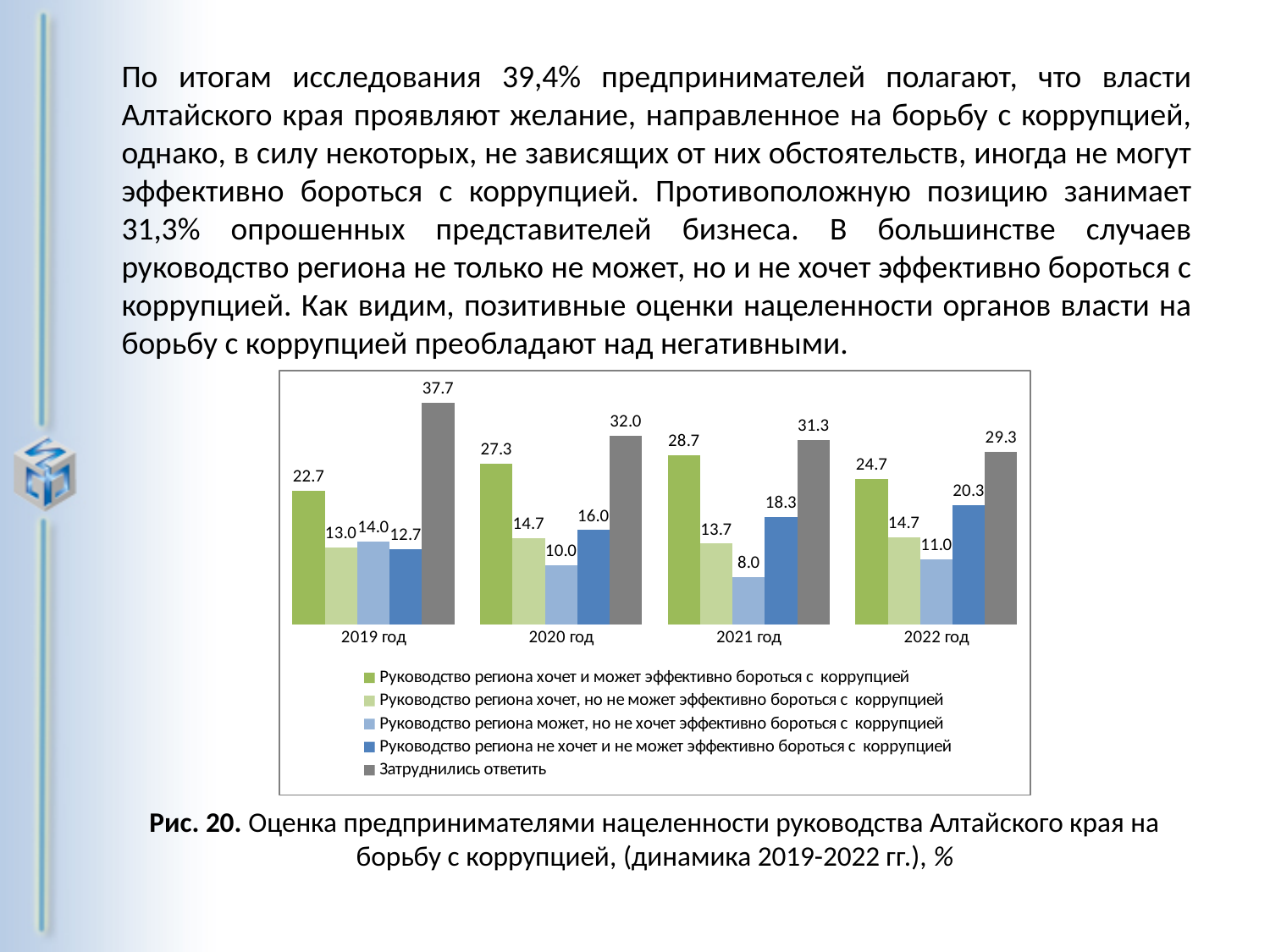
How does the value for 'Руководство региона не хочет и не может эффективно бороться с коррупцией' change from 2019 год to 2022 год? rises In which year is the value for 'Затруднились ответить' the highest? 2019 год What is the value for 'Руководство региона не хочет и не может эффективно бороться с коррупцией' in 2022 год? 20.3 Which is larger in 2020 год: 'Руководство региона хочет, но не может эффективно бороться с коррупцией' or 'Руководство региона не хочет и не может эффективно бороться с коррупцией'? Руководство региона не хочет и не может эффективно бороться с коррупцией What is the difference between the 'Затруднились ответить' values in 2019 год and 2022 год? 8.4 In which year is the value for 'Руководство региона может, но не хочет эффективно бороться с коррупцией' the lowest? 2021 год What colour are the bars for 'Затруднились ответить'? grey What type of chart is shown on the slide? bar chart How many series does the legend list? 5 How many year categories are shown on the x axis? 4 What is the value for 'Руководство региона хочет и может эффективно бороться с коррупцией' in 2021 год? 28.7 What is the value for 'Затруднились ответить' in 2019 год? 37.7